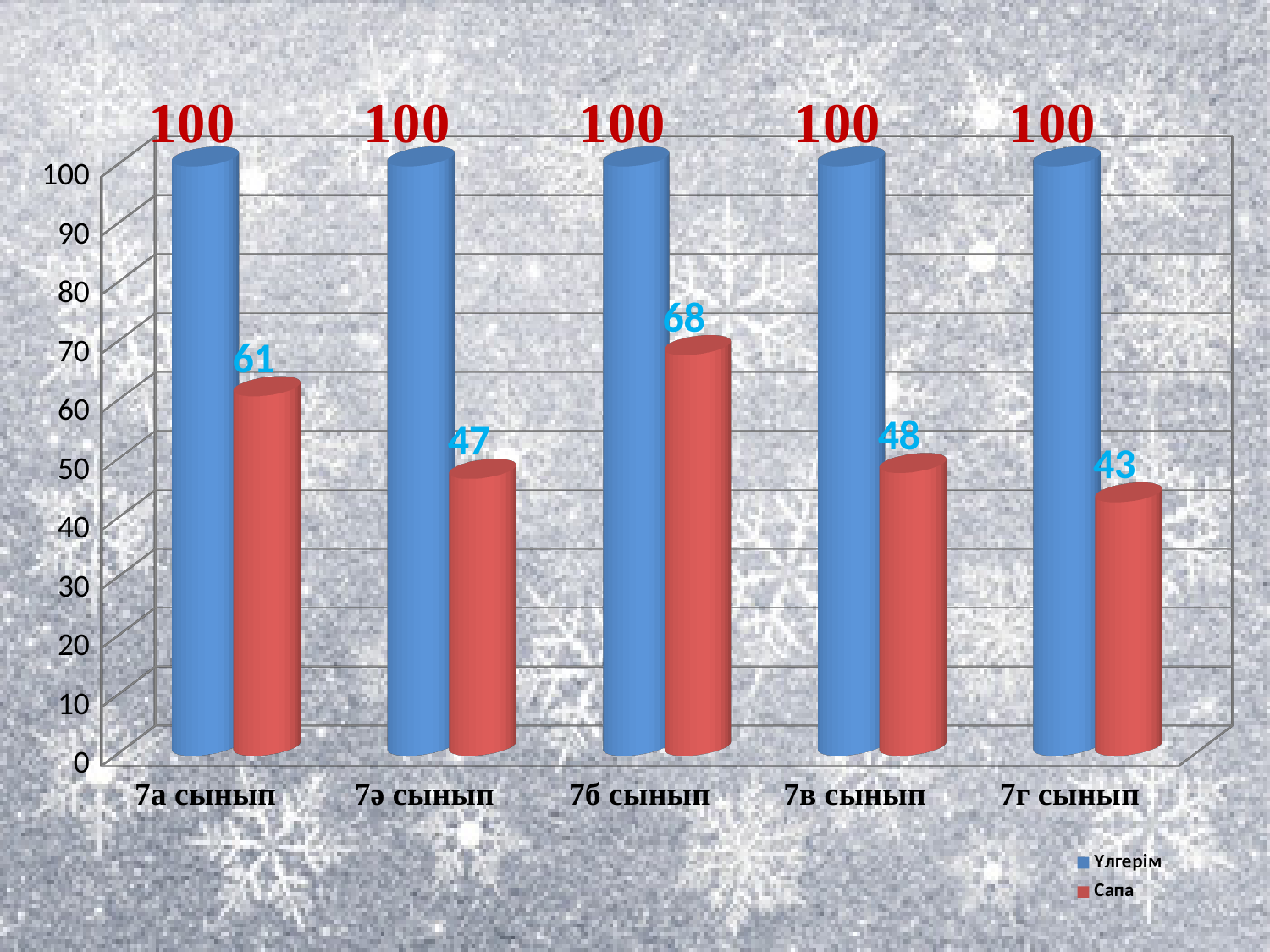
Which category has the highest Сапа value? 7б сынып What is the Сапа value for 7б сынып? 68 What kind of chart is shown on the slide? Bar chart Which category has the lowest Сапа value? 7г сынып What is the Сапа value for 7г сынып? 43 What is the difference between the Сапа values for 7б сынып and 7г сынып? 25 How many categories are shown on the x axis? 5 How many series does the legend list? 2 What is the Үлгерім value for 7а сынып? 100 Which is larger, the Сапа value for 7а сынып or for 7ә сынып? 7а сынып Which series is shown in red? Сапа What is the difference between the Үлгерім and Сапа values for 7а сынып? 39